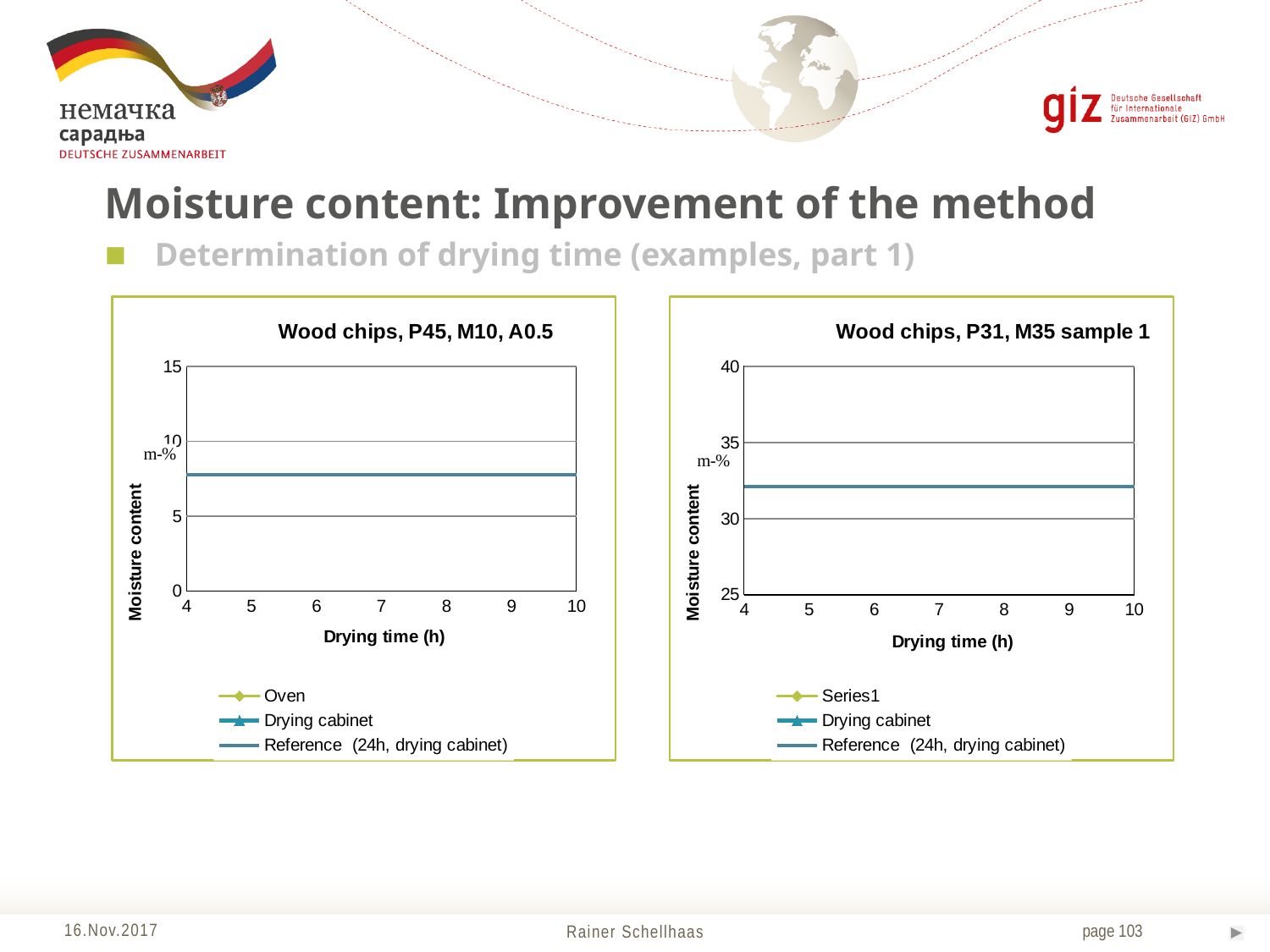
In the left chart (Wood chips, P45, M10, A0.5), is the value of the Reference (24h, drying cabinet) line greater or less than 5? greater What kind of chart is the right chart titled "Wood chips, P31, M35 sample 1"? line chart In the left chart (Wood chips, P45, M10, A0.5), does the Reference (24h, drying cabinet) line rise, fall or stay constant as drying time increases from 4 to 10 h? stays constant What is the first legend entry of the left chart (Wood chips, P45, M10, A0.5)? Oven How many series does the legend of the left chart (Wood chips, P45, M10, A0.5) list? 3 What is the x-axis label of the right chart (Wood chips, P31, M35 sample 1)? Drying time (h) In the right chart (Wood chips, P31, M35 sample 1), is the value of the Reference (24h, drying cabinet) line greater or less than 35? less In the right chart (Wood chips, P31, M35 sample 1), does the Reference (24h, drying cabinet) line rise, fall or stay constant along the x axis? stays constant In the right chart (Wood chips, P31, M35 sample 1), is the value of the Reference (24h, drying cabinet) line greater or less than 30? greater How many series does the legend of the right chart (Wood chips, P31, M35 sample 1) list? 3 What kind of chart is the left chart titled "Wood chips, P45, M10, A0.5"? line chart